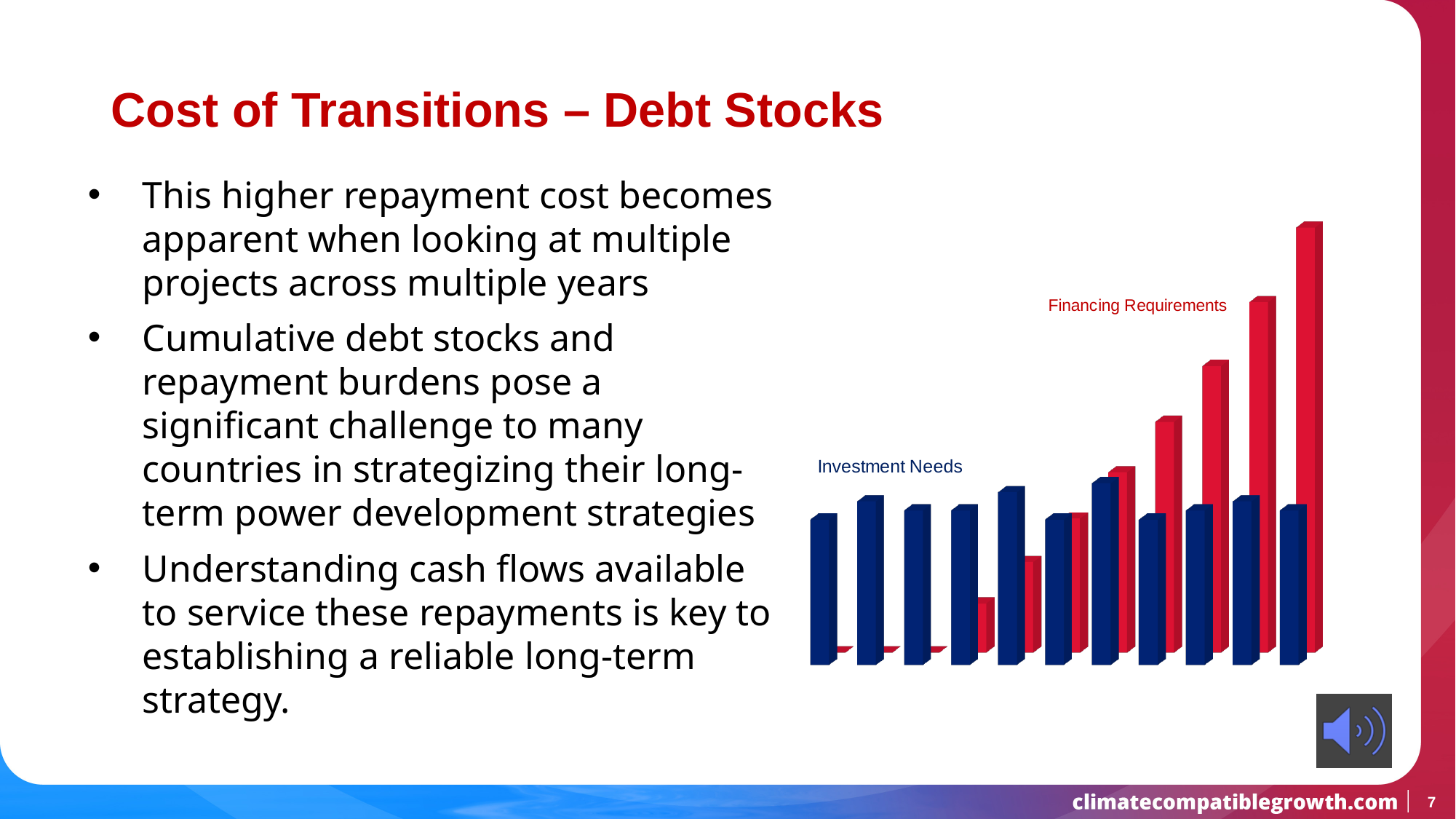
How many groups of bars are plotted in the chart? 11 Do the Financing Requirements values rise or fall from left to right across the chart? rise Which colour represents the Financing Requirements series? red How many data series does the chart show? 2 In the leftmost group of bars, which series has the larger value, Investment Needs or Financing Requirements? Investment Needs What kind of chart is shown on the slide? bar chart What are the names of the two series in the chart? Investment Needs and Financing Requirements Which series has the tallest bar in the chart? Financing Requirements In the rightmost group of bars, which series has the larger value, Investment Needs or Financing Requirements? Financing Requirements